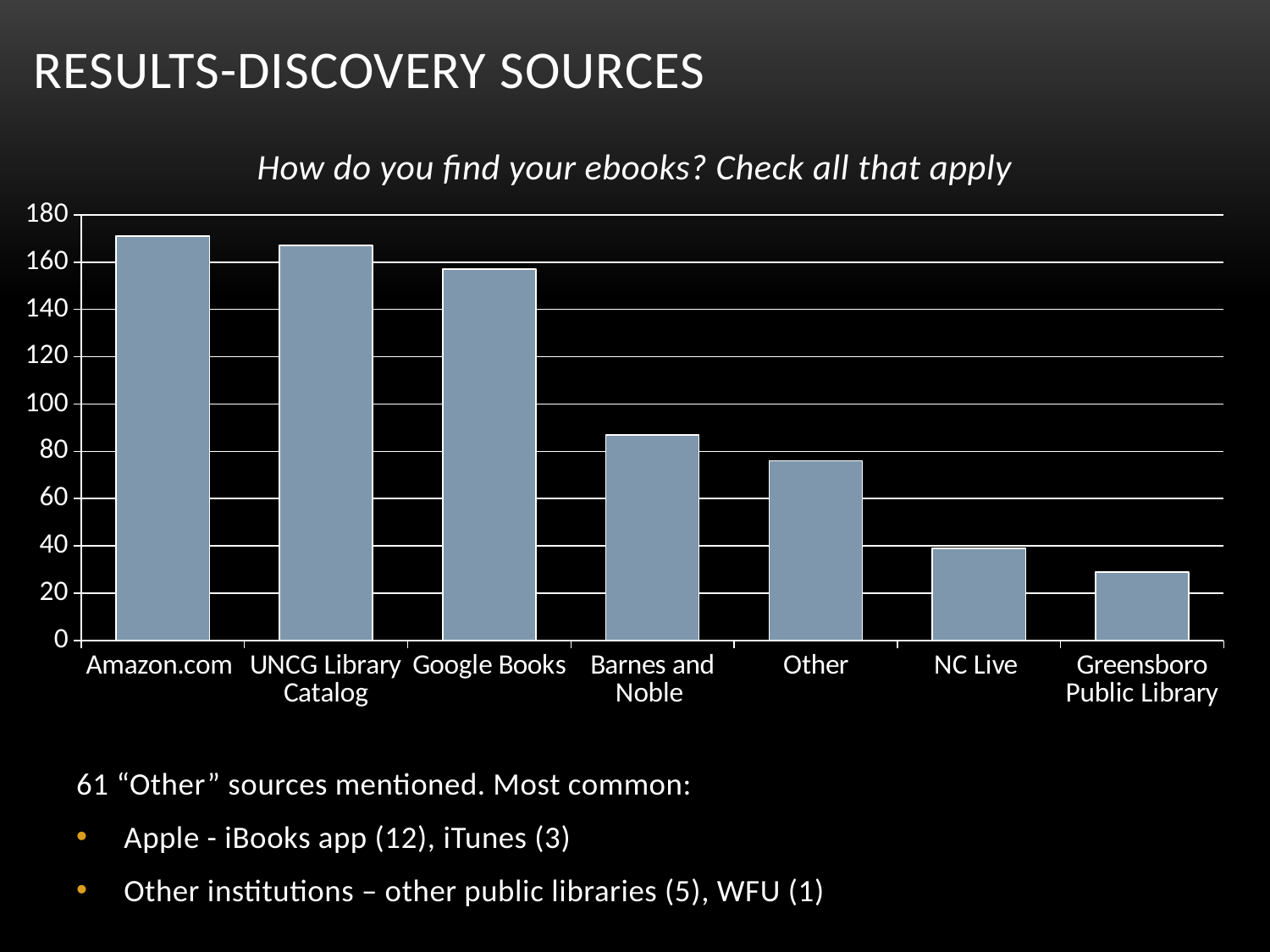
How many discovery sources (categories) are shown on the x axis of the chart? 7 What kind of chart is shown on the slide? bar chart Do the values rise or fall moving from left to right along the x axis? fall What is the title of the chart? How do you find your ebooks? Check all that apply Is the value for Greensboro Public Library greater or less than 40? less Is the value for Google Books greater or less than 140? greater Is the value for Barnes and Noble greater or less than 100? less Which has a larger value, Google Books or Barnes and Noble? Google Books Which discovery source has the lowest value in the chart? Greensboro Public Library